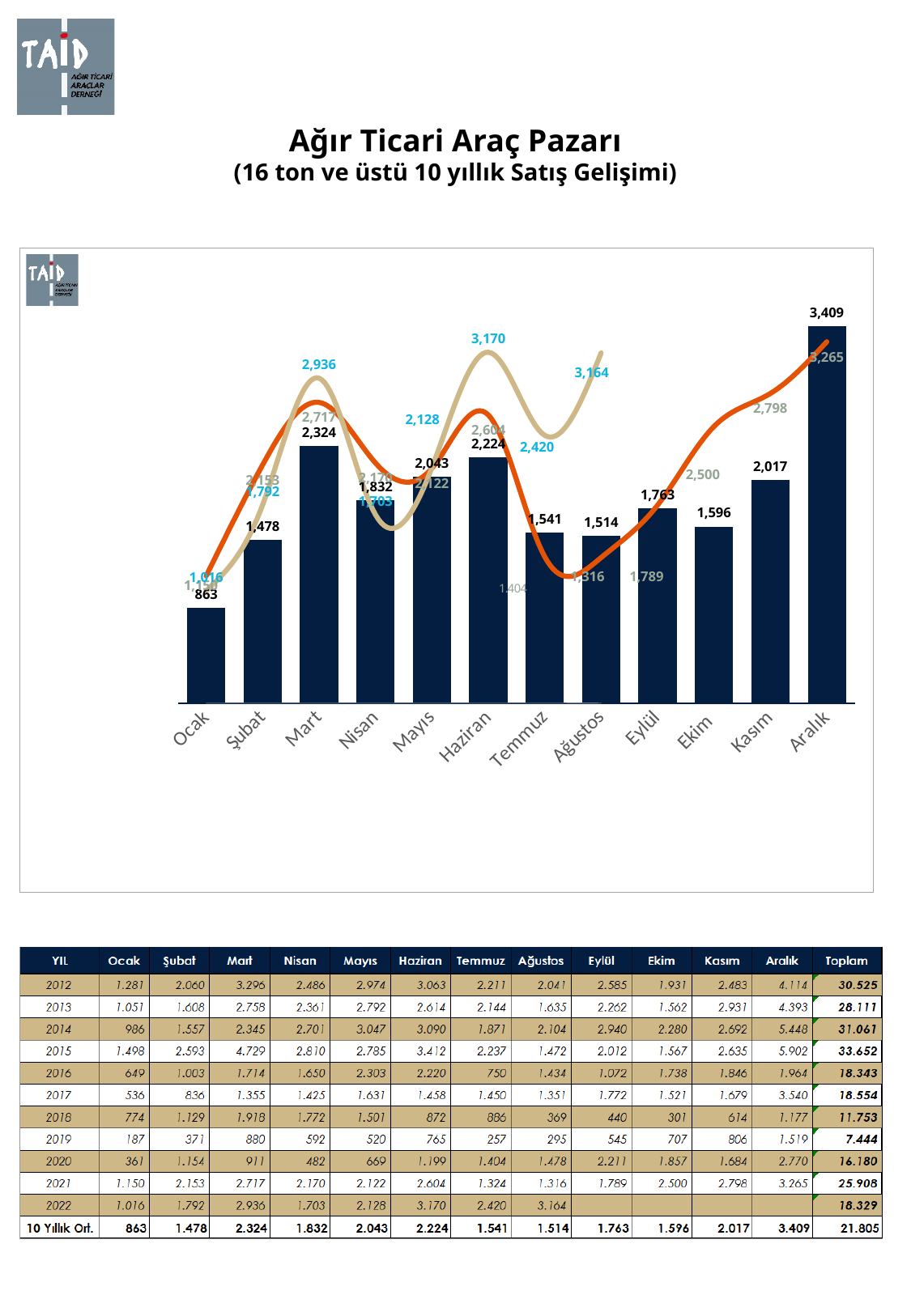
What is the value of the bar for Temmuz? 1,541 How many months are shown on the x axis of the chart? 12 What kind of chart is shown on the slide? bar chart with two line overlays Which bar is taller, Mayıs or Haziran? Haziran Which month has the highest bar? Aralık What is the difference between the bar values for Aralık and Kasım? 1,392 What is the difference between the bar values for Mart and Şubat? 846 Do the bar values rise or fall from Ekim to Aralık? rise What is the value of the bar for Mart? 2,324 What is the value of the bar for Ağustos? 1,514 What is the value of the bar for Aralık? 3,409 Which month has the lowest bar? Ocak